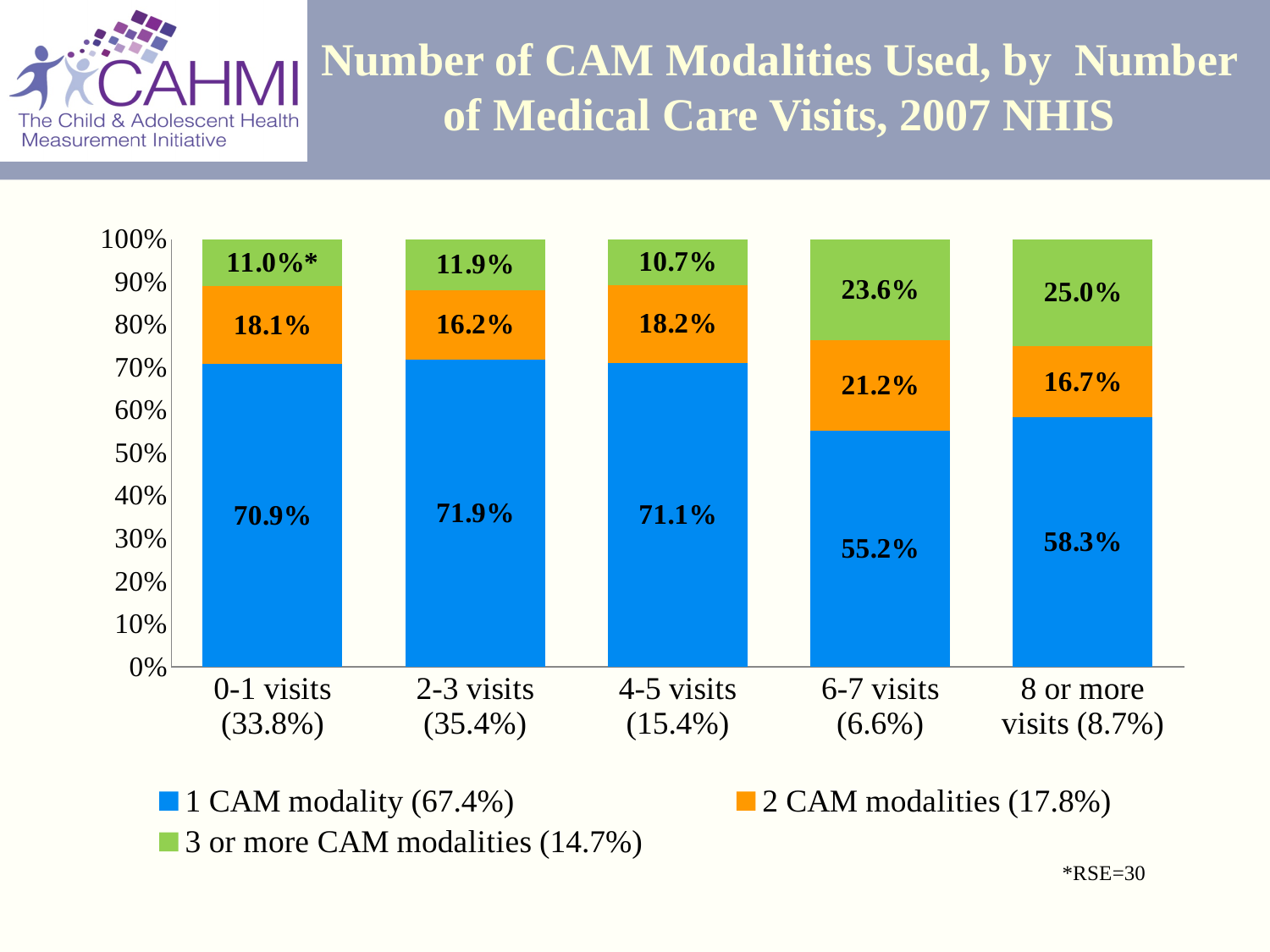
What is the title of the chart? Number of CAM Modalities Used, by Number of Medical Care Visits, 2007 NHIS What is the value for 2 CAM modalities in the 2-3 visits category? 16.2% What is the value for 3 or more CAM modalities in the 8 or more visits category? 25.0% Which visit category has the highest value for 1 CAM modality? 2-3 visits (35.4%) Which colour represents 2 CAM modalities in the chart? Orange What kind of chart is shown on the slide? Stacked bar chart Which visit category has the lowest value for 3 or more CAM modalities? 4-5 visits (15.4%) How many visit categories are shown on the x axis? 5 How many series does the legend list? 3 Which is larger: the 2 CAM modalities value for 6-7 visits or for 8 or more visits? 6-7 visits (6.6%) What is the difference between the 1 CAM modality values for 0-1 visits and 6-7 visits? 15.7% What percentage of children with 6-7 visits used 1 CAM modality? 55.2%